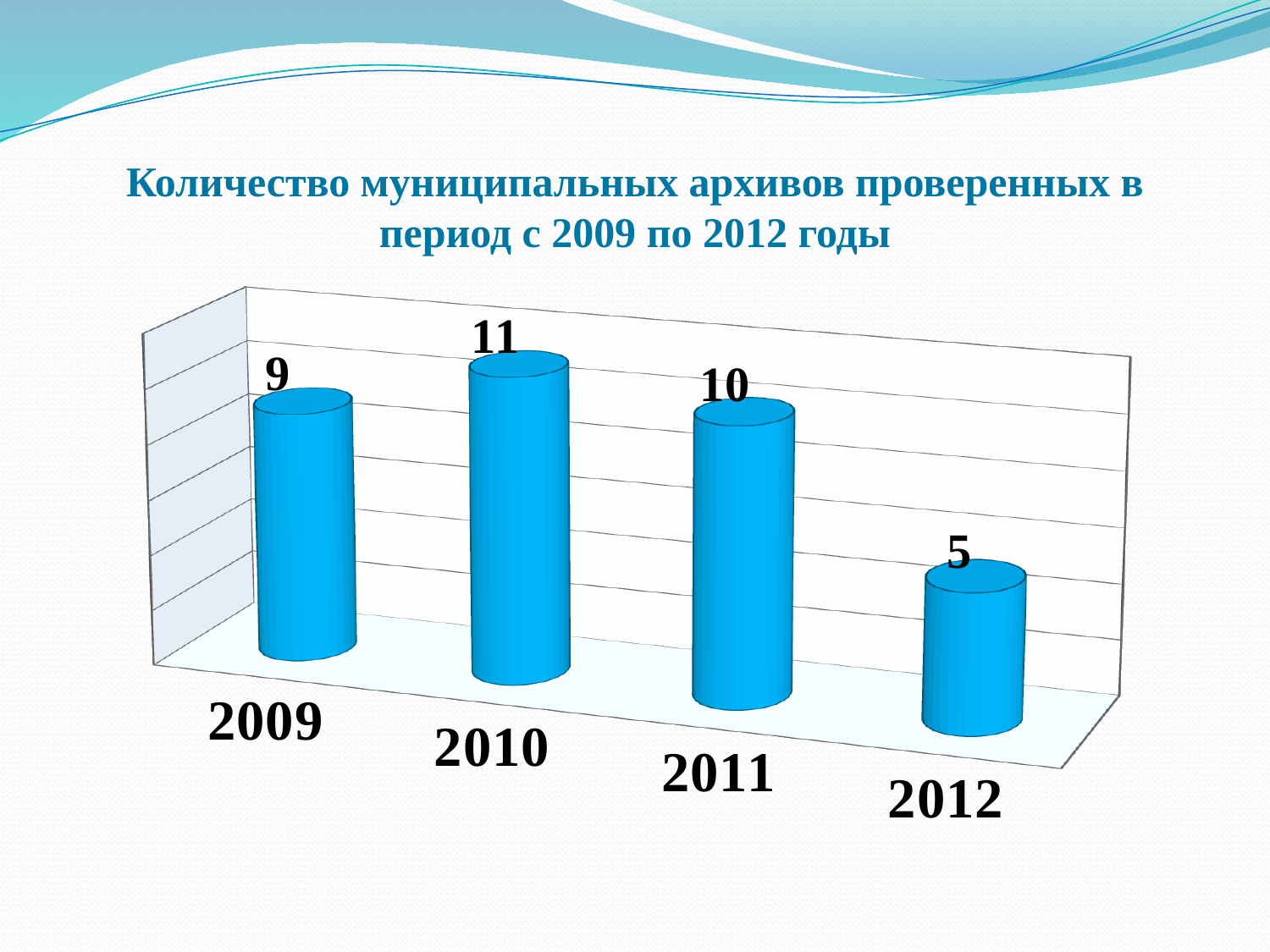
Which year has the highest value? 2010 Which year has the lowest value? 2012 What is the value for 2012? 5 What is the difference between the values for 2010 and 2012? 6 How many years are shown on the chart? 4 What is the value for 2011? 10 What is the difference between the values for 2011 and 2009? 1 What kind of chart is shown on the slide? Bar chart Which is larger, the value for 2009 or the value for 2012? 2009 What is the value for 2009? 9 Do the values rise or fall from 2011 to 2012? Fall What is the value for 2010? 11